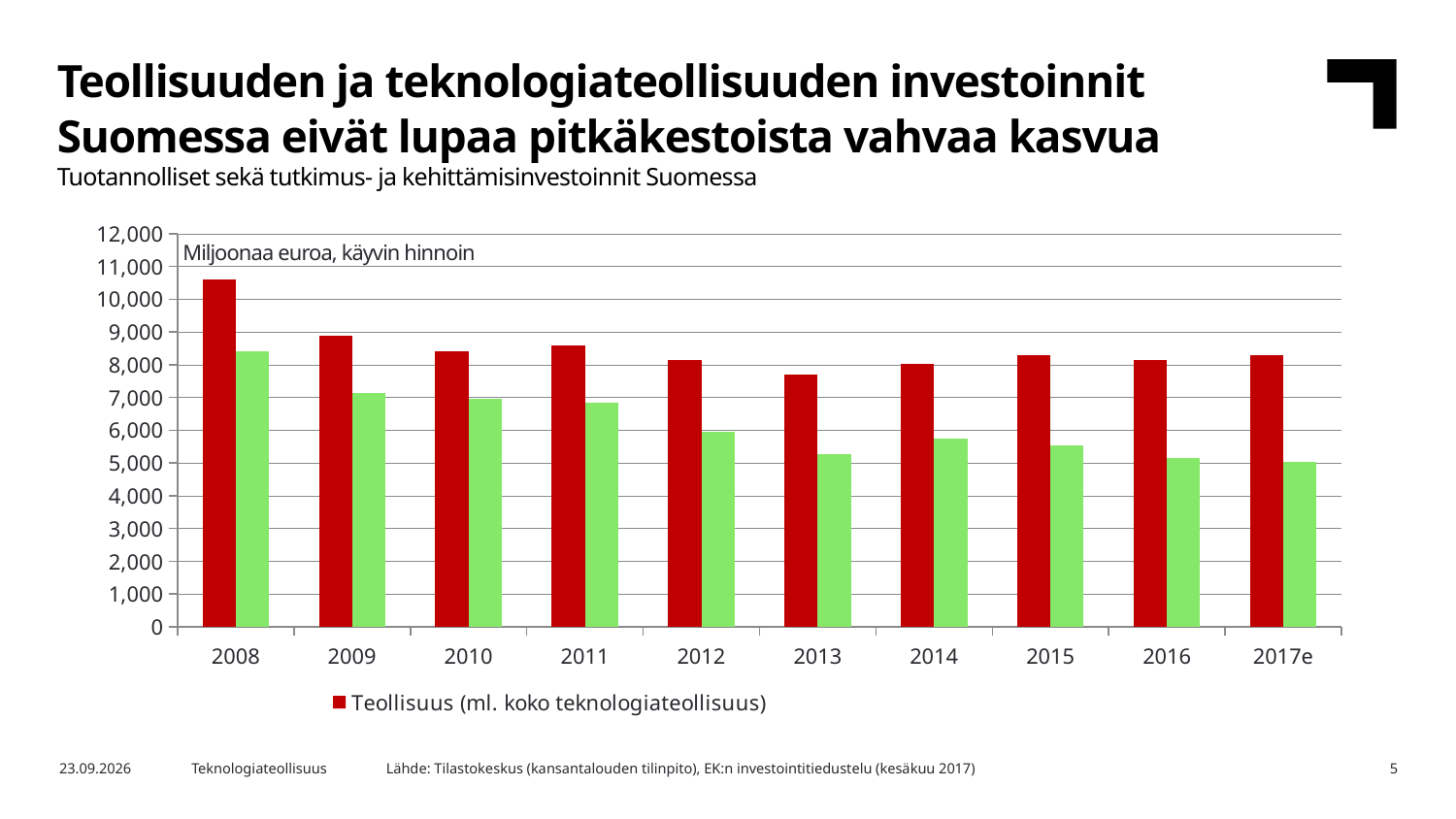
Is the value of the green bar for 2012 greater or less than 7,000? less What unit label is shown inside the chart's plot area? Miljoonaa euroa, käyvin hinnoin Which year has the lowest value for Teollisuus (ml. koko teknologiateollisuus)? 2013 What kind of chart is shown on the slide? bar chart Do the values of the green series generally rise or fall from 2008 to 2017e? fall Which is larger for Teollisuus (ml. koko teknologiateollisuus): the value for 2009 or the value for 2010? 2009 Is the value for Teollisuus (ml. koko teknologiateollisuus) in 2013 greater or less than 8,000? less Which year has the highest value for the green series? 2008 Which year has the highest value for Teollisuus (ml. koko teknologiateollisuus)? 2008 How many series does the chart's legend list? 1 Is the value for Teollisuus (ml. koko teknologiateollisuus) in 2008 greater or less than 10,000? greater How many years are shown on the x axis of the chart? 10